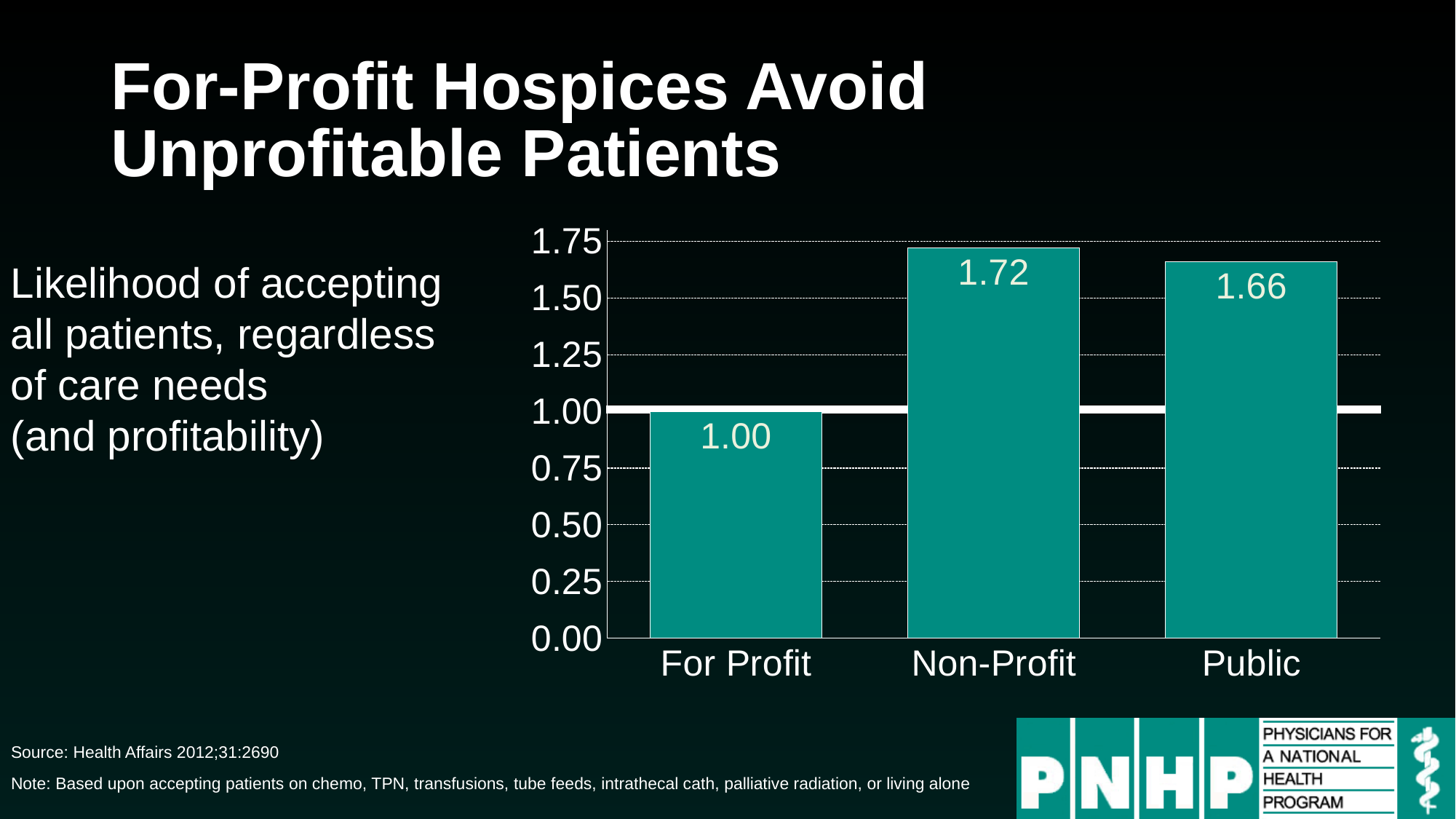
What is the highest tick value shown on the y axis? 1.75 What is the value for Non-Profit hospices? 1.72 What is the difference between the Non-Profit and For Profit values? 0.72 Which category has the highest value? Non-Profit What is the value for Public hospices? 1.66 Is the value for Public greater or less than 1.50? greater How many categories are shown on the x axis? 3 What kind of chart is shown on the slide? Bar chart Which category has the lowest value? For Profit What is the value for For Profit hospices? 1.00 Which is larger, the value for Public or the value for For Profit? Public What is the difference between the Public and For Profit values? 0.66